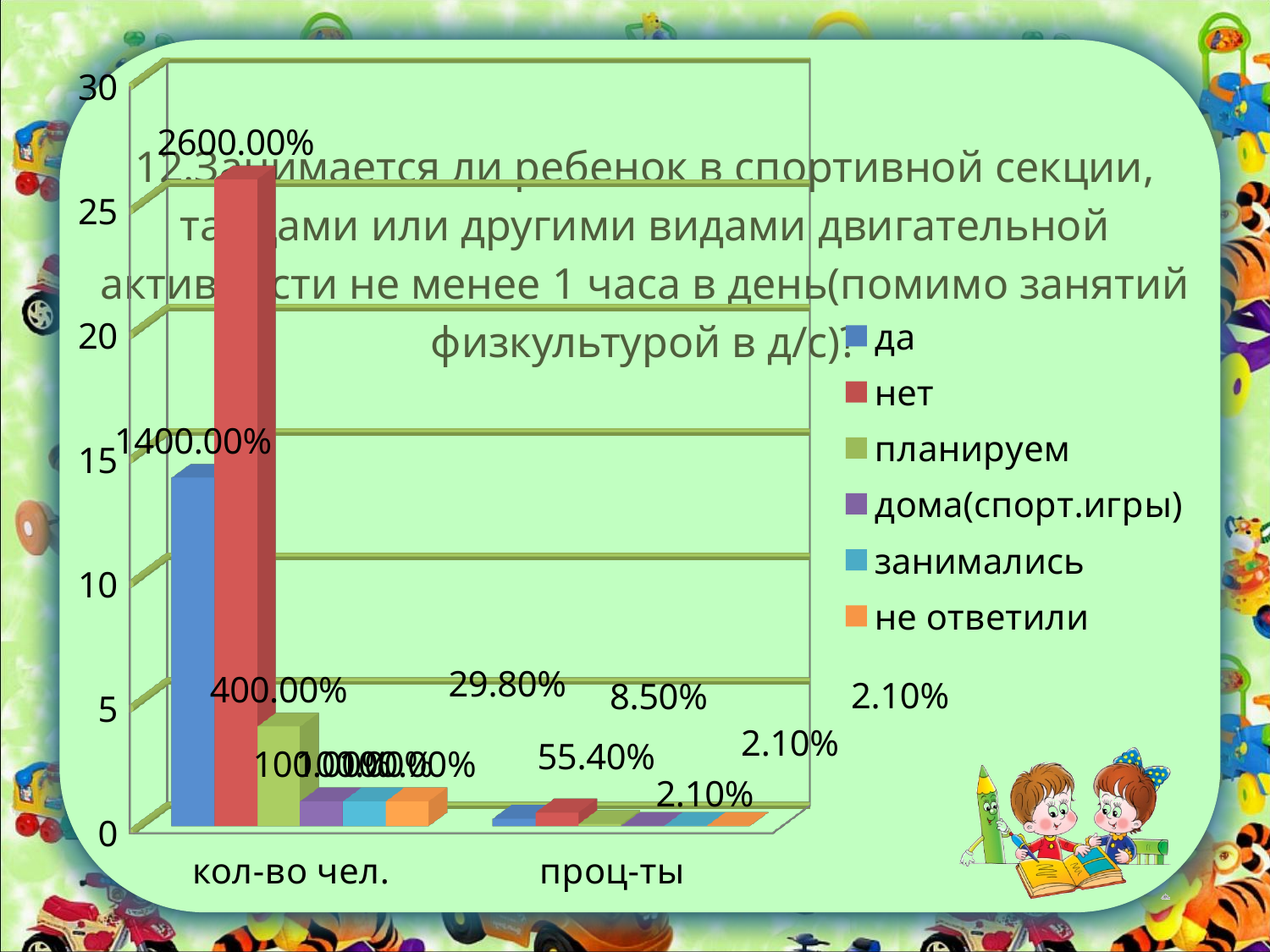
What is the data label for 'нет' in the 'проц-ты' category? 55.40% How many categories are shown on the x axis? 2 What is the data label for 'да' in the 'проц-ты' category? 29.80% How many series does the legend list? 6 What kind of chart is shown on the slide? bar chart Which series has the tallest bar in the 'кол-во чел.' category? нет What is the data label for 'нет' in the 'кол-во чел.' category? 2600.00% What is the data label for 'планируем' in the 'проц-ты' category? 8.50% In the 'кол-во чел.' category, which is larger: 'да' or 'планируем'? да Is the bar for 'нет' in the 'кол-во чел.' category greater or less than 25 on the axis? greater What is the data label for 'планируем' in the 'кол-во чел.' category? 400.00% What is the data label for 'да' in the 'кол-во чел.' category? 1400.00%